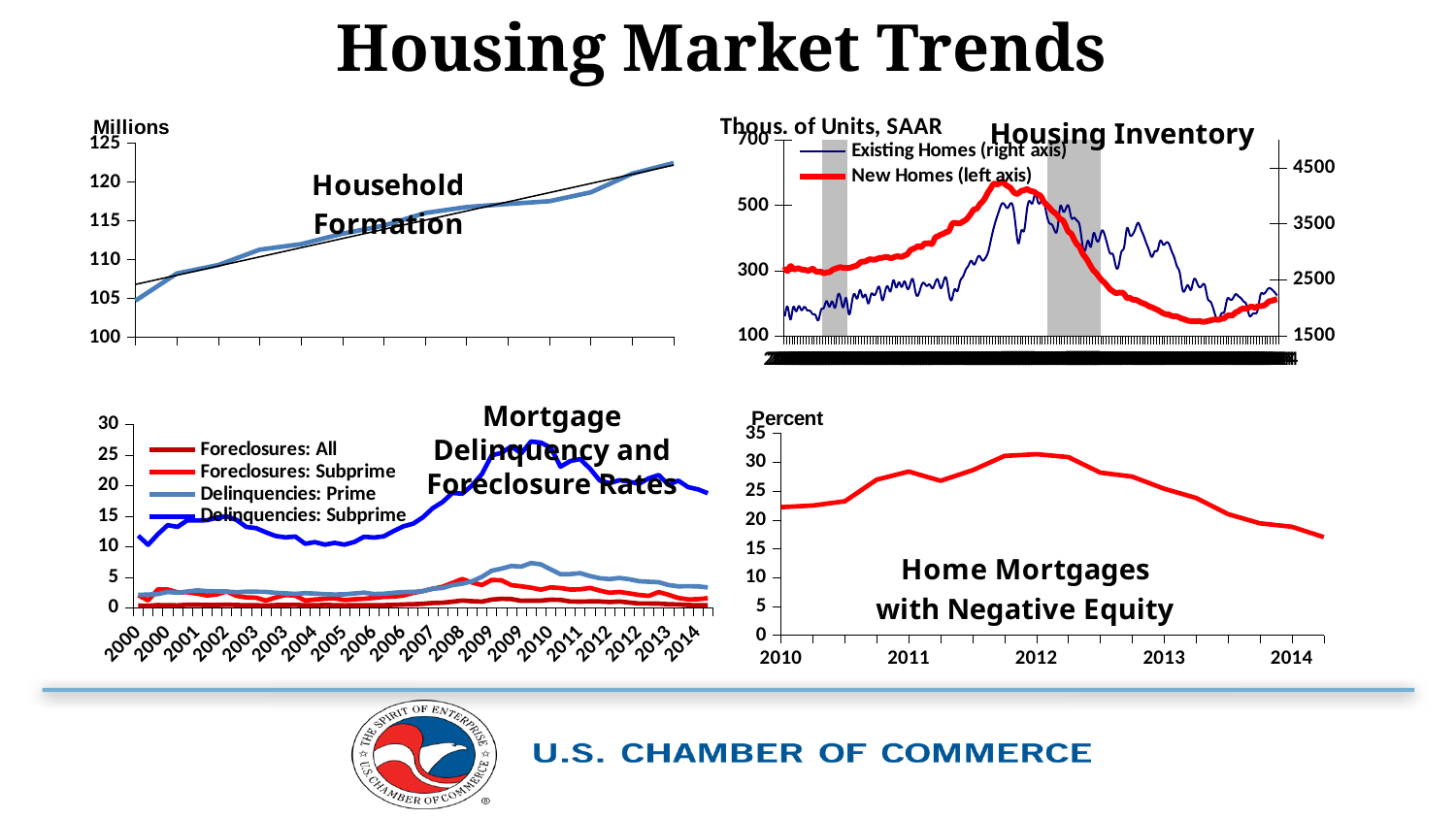
How many charts are shown on the slide? 4 In the Home Mortgages with Negative Equity chart, is the value at 2014 greater or less than 20? less In the Housing Inventory chart, is the peak value of New Homes greater or less than 500? greater In the Household Formation chart, is the value at the start of the series greater or less than 110? less How many series does the legend of the Mortgage Delinquency and Foreclosure Rates chart list? 4 In the Household Formation chart, do the values rise or fall from left to right? rise What kind of chart is the Household Formation chart? line chart How many series does the legend of the Housing Inventory chart list? 2 In the Mortgage Delinquency and Foreclosure Rates chart, which series reaches the highest value? Delinquencies: Subprime In the Housing Inventory chart, which series is plotted on the right axis? Existing Homes